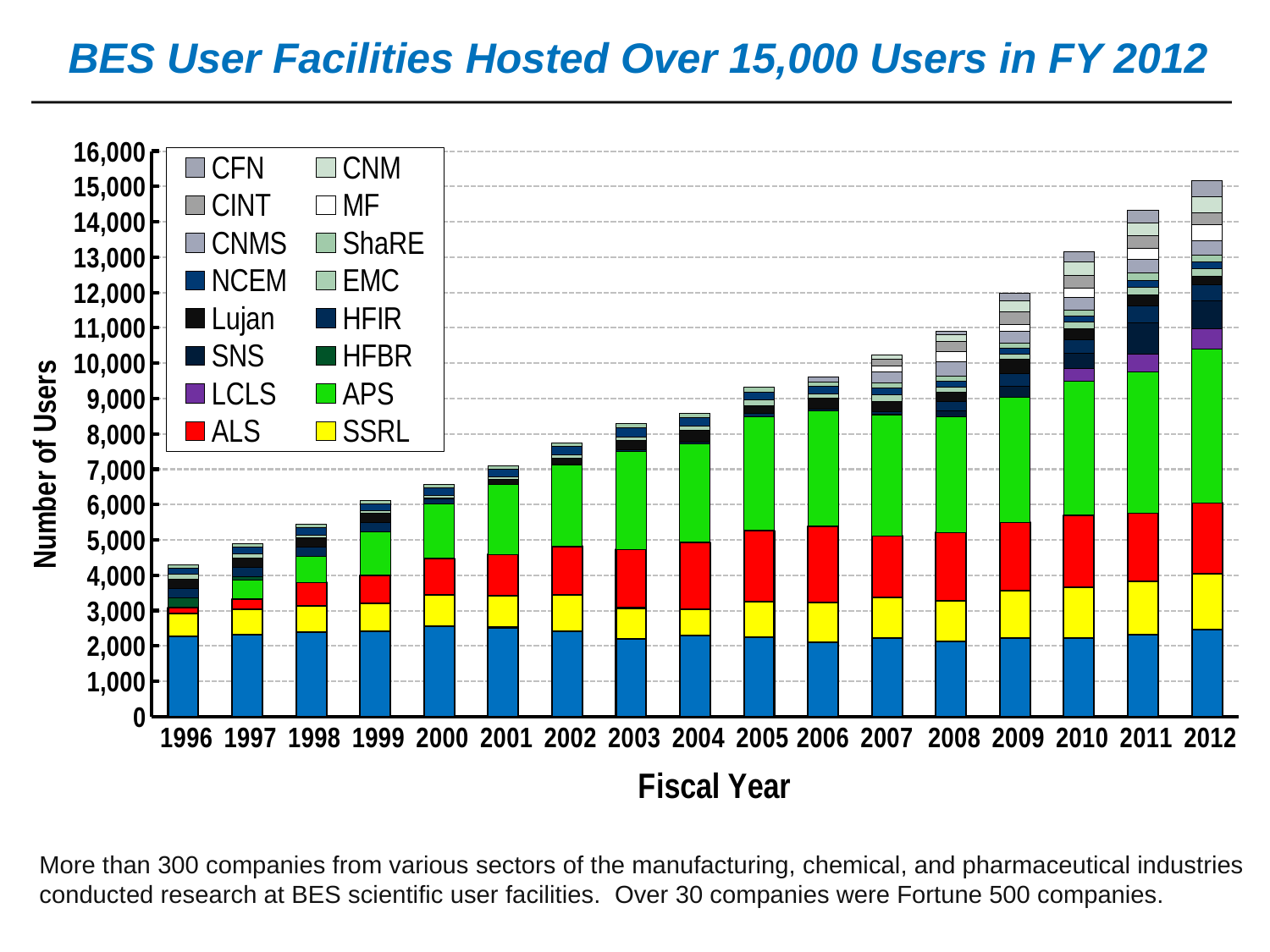
Do the total numbers of users generally rise or fall from 1996 to 2012? rise Is the total number of users in 1996 greater or less than 5,000? less Which fiscal year has the lowest total number of users? 1996 Is the total number of users in 2012 greater or less than 15,000? greater Which fiscal year has a larger total number of users, 2003 or 2009? 2009 Is the total number of users in 2005 greater or less than 10,000? less What kind of chart is shown on the slide? Stacked bar chart Which fiscal year has the highest total number of users? 2012 How many series does the chart's legend list? 16 How many fiscal years are shown along the x axis of the chart? 17 What is the label of the chart's vertical axis? Number of Users